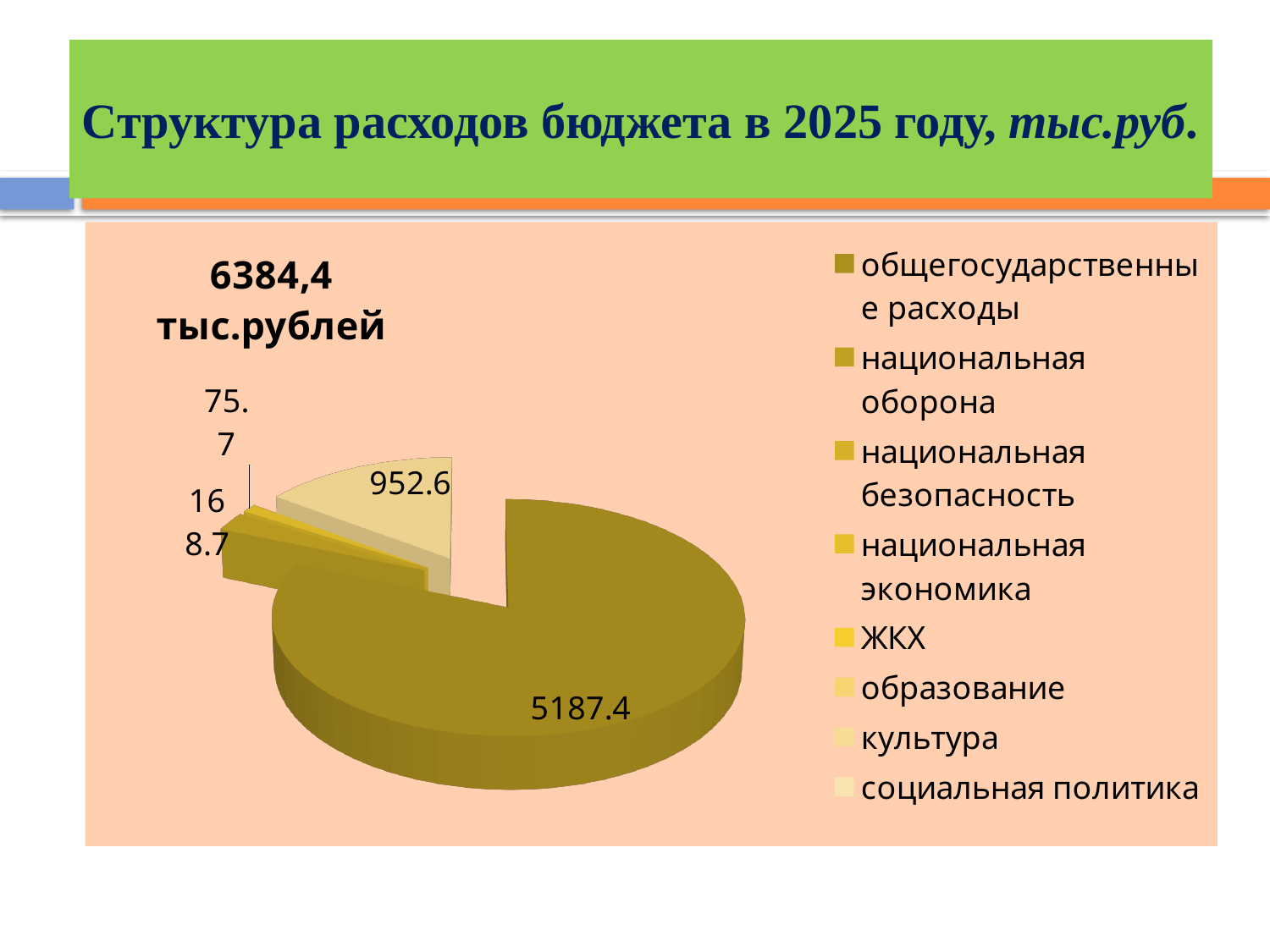
What is the difference between the slice labelled 5187.4 and the slice labelled 952.6? 4234.8 What is the value of the largest slice of the pie chart? 5187.4 What title is printed above the pie chart? 6384,4 тыс.рублей How many data labels are printed on the pie chart? 4 What is the smallest value printed as a data label on the pie chart? 75.7 Which is larger, the slice labelled 952.6 or the slice labelled 75.7? 952.6 What kind of chart is shown on the slide? pie chart How many entries does the legend of the pie chart list? 8 What is the last entry in the legend of the pie chart? социальная политика Is the value of the largest slice greater or less than 5000? greater Which category has the largest slice of the pie chart? общегосударственные расходы